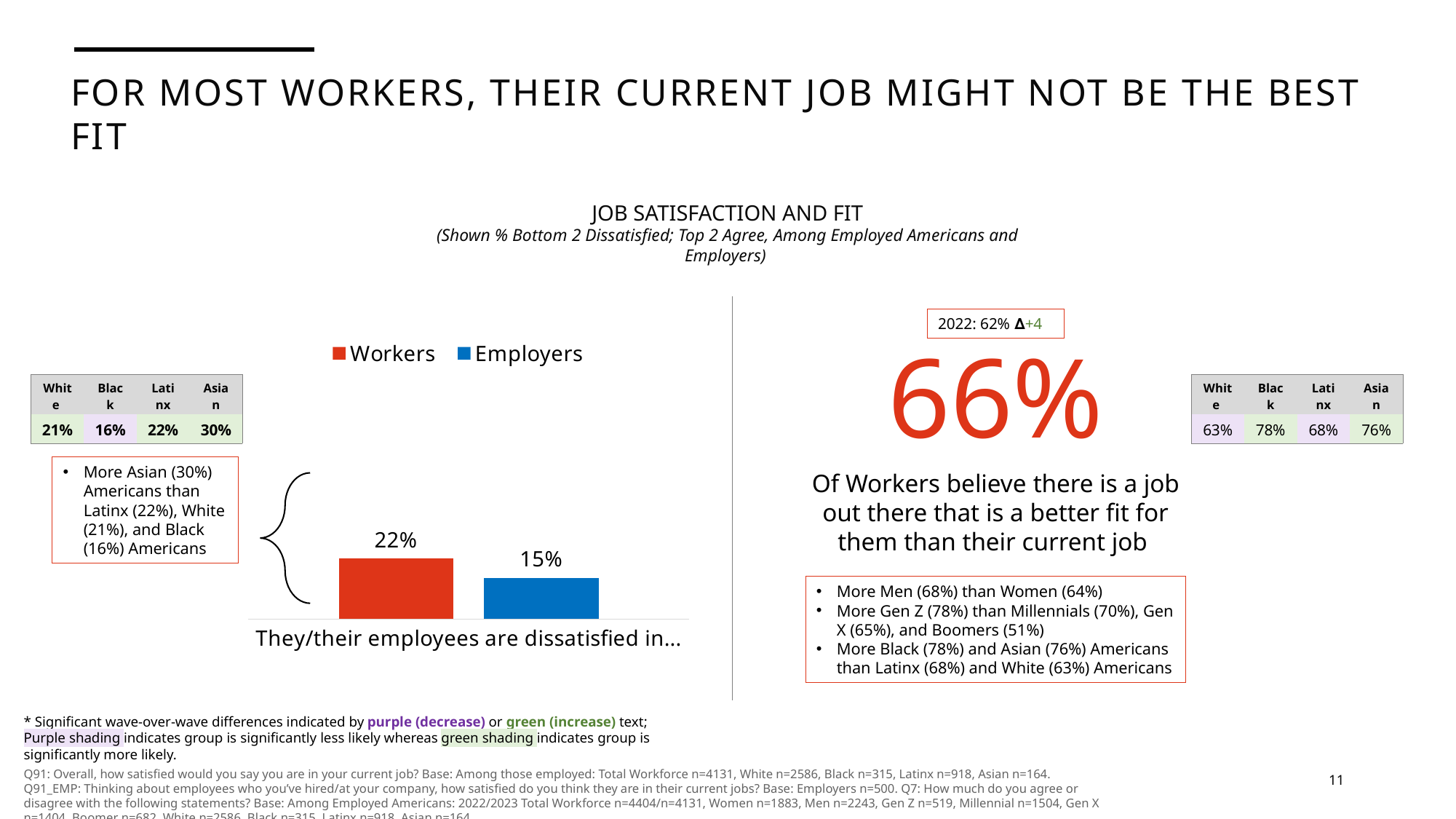
What percentage of Workers say they are dissatisfied in their current job, according to the bar chart? 22% What percentage do Employers give for their employees being dissatisfied, according to the bar chart? 15% Is the Workers value in the bar chart greater or less than 20%? greater Which series has the lowest value in the bar chart? Employers How many series does the legend of the bar chart list? 2 What colour is the Workers bar in the chart? Red What type of chart is used to show the dissatisfaction percentages? Bar chart What is the category label shown beneath the bars in the chart? They/their employees are dissatisfied in… What is the difference in percentage points between the Workers bar and the Employers bar? 7 percentage points Which series has the taller bar in the bar chart, Workers or Employers? Workers How many bars are plotted in the bar chart? 2